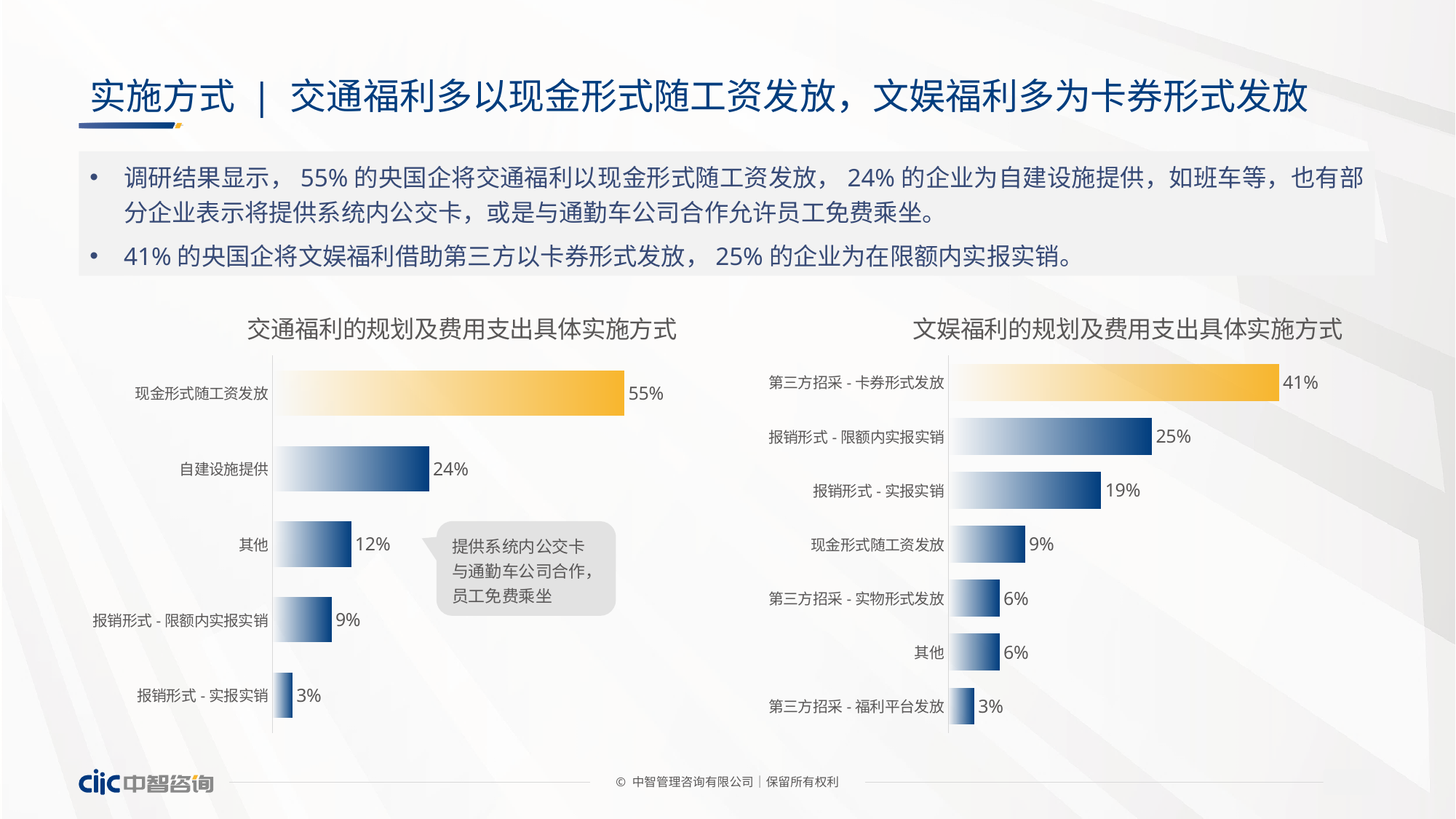
In the right chart (文娱福利的规划及费用支出具体实施方式), what is the value for 现金形式随工资发放? 9% In the right chart (文娱福利的规划及费用支出具体实施方式), what is the difference between 第三方招采 - 卡券形式发放 and 报销形式 - 限额内实报实销? 16% In the right chart (文娱福利的规划及费用支出具体实施方式), how many categories are shown? 7 In the right chart (文娱福利的规划及费用支出具体实施方式), which category has the highest value? 第三方招采 - 卡券形式发放 In the right chart (文娱福利的规划及费用支出具体实施方式), which is larger: 报销形式 - 实报实销 or 现金形式随工资发放? 报销形式 - 实报实销 What type of chart is the left chart (交通福利的规划及费用支出具体实施方式)? Bar chart In the right chart (文娱福利的规划及费用支出具体实施方式), what is the value for 报销形式 - 限额内实报实销? 25% In the left chart (交通福利的规划及费用支出具体实施方式), how many categories are shown? 5 In the left chart (交通福利的规划及费用支出具体实施方式), which category has the lowest value? 报销形式 - 实报实销 In the left chart (交通福利的规划及费用支出具体实施方式), what is the value for 自建设施提供? 24% In the left chart (交通福利的规划及费用支出具体实施方式), what is the value for 现金形式随工资发放? 55% In the left chart (交通福利的规划及费用支出具体实施方式), what is the difference between 现金形式随工资发放 and 自建设施提供? 31%